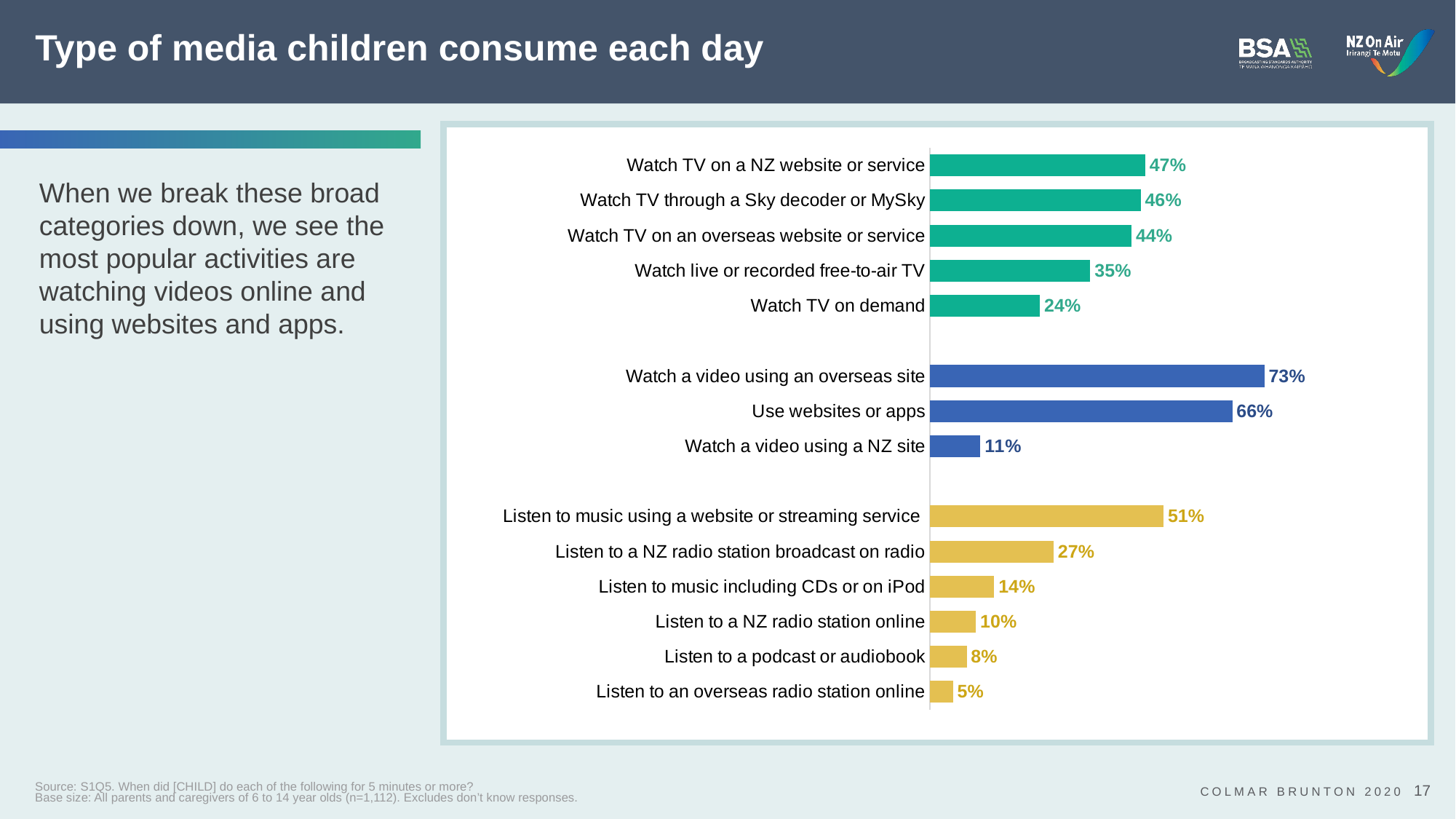
Which activity has the highest value on the chart? Watch a video using an overseas site Which is larger: 'Listen to music using a website or streaming service' or 'Watch TV through a Sky decoder or MySky'? Listen to music using a website or streaming service What type of chart is shown on the slide? Bar chart How many activities are plotted on the chart? 14 What is the value for 'Listen to a NZ radio station broadcast on radio'? 27% What colour are the bars for the 'Listen to' activities? Yellow Which activity has the lowest value on the chart? Listen to an overseas radio station online Which is larger: 'Listen to a podcast or audiobook' or 'Listen to a NZ radio station online'? Listen to a NZ radio station online What is the difference between 'Use websites or apps' and 'Watch a video using a NZ site'? 55% What percentage of children watch a video using an overseas site each day? 73% What is the difference between 'Watch TV on a NZ website or service' and 'Watch live or recorded free-to-air TV'? 12% What percentage is shown for 'Watch TV on demand'? 24%